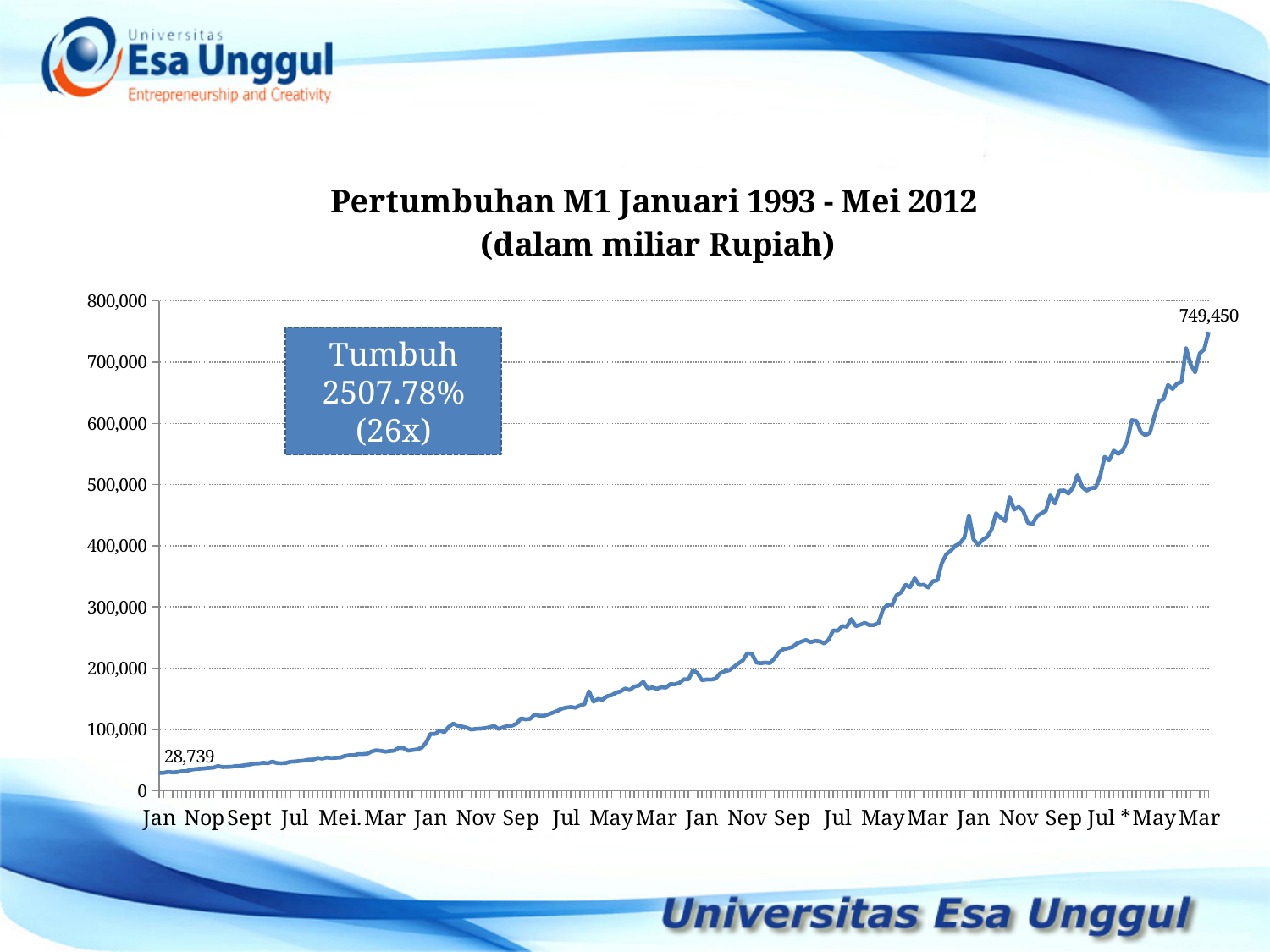
Does the M1 line generally rise or fall from left to right along the x axis? rise What is the difference between the final value (749,450) and the initial value (28,739) of M1? 720,711 What is the title of the chart? Pertumbuhan M1 Januari 1993 - Mei 2012 (dalam miliar Rupiah) Is the lowest value on the line greater or less than 100,000? less What is the value of M1 at the start of the series (January 1993)? 28,739 Which of the two labelled values is larger, the starting value or the ending value? the ending value (749,450) What is the value of M1 at the end of the series (May 2012)? 749,450 Is the highest value on the line greater or less than 700,000? greater What growth percentage is stated in the text box on the chart? 2507.78% (26x) What is the highest value labelled on the chart? 749,450 What is the lowest value labelled on the chart? 28,739 What kind of chart is shown on the slide? line chart